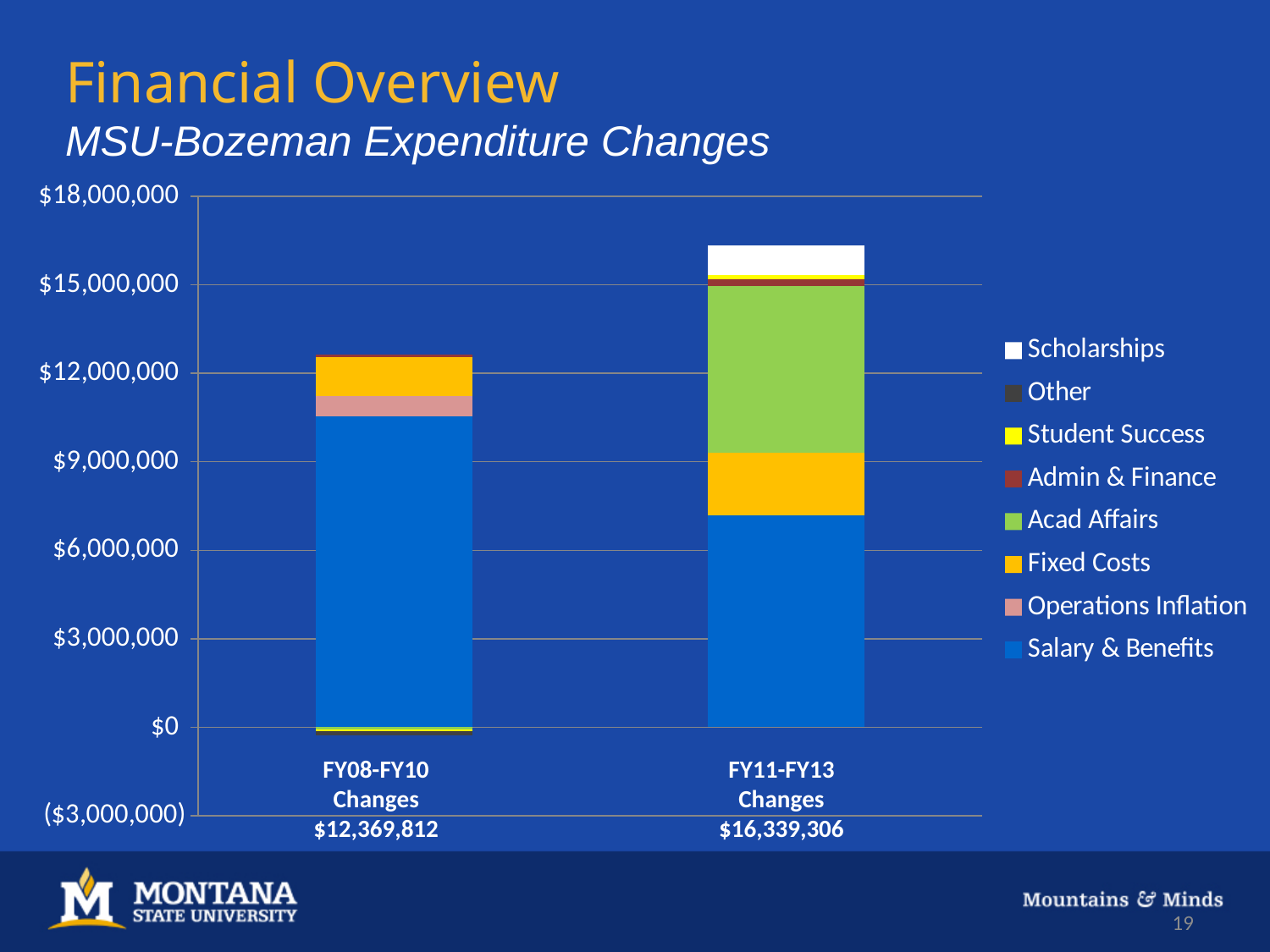
What kind of chart is shown on the slide? Stacked bar chart Which period has the larger Acad Affairs segment, FY08-FY10 Changes or FY11-FY13 Changes? FY11-FY13 Changes What is the difference between the FY11-FY13 Changes total and the FY08-FY10 Changes total? $3,969,494 Which period has the larger total expenditure change? FY11-FY13 Changes What is the subtitle of the chart on the slide? MSU-Bozeman Expenditure Changes Is the Salary & Benefits value for FY11-FY13 Changes greater or less than $9,000,000? less What is the total expenditure change shown for FY11-FY13 Changes? $16,339,306 What is the total expenditure change shown for FY08-FY10 Changes? $12,369,812 How many categories (bars) are plotted on the x axis? 2 How many series does the legend list? 8 Do the total expenditure changes rise or fall from FY08-FY10 to FY11-FY13? Rise Is the Salary & Benefits value for FY08-FY10 Changes greater or less than $9,000,000? greater